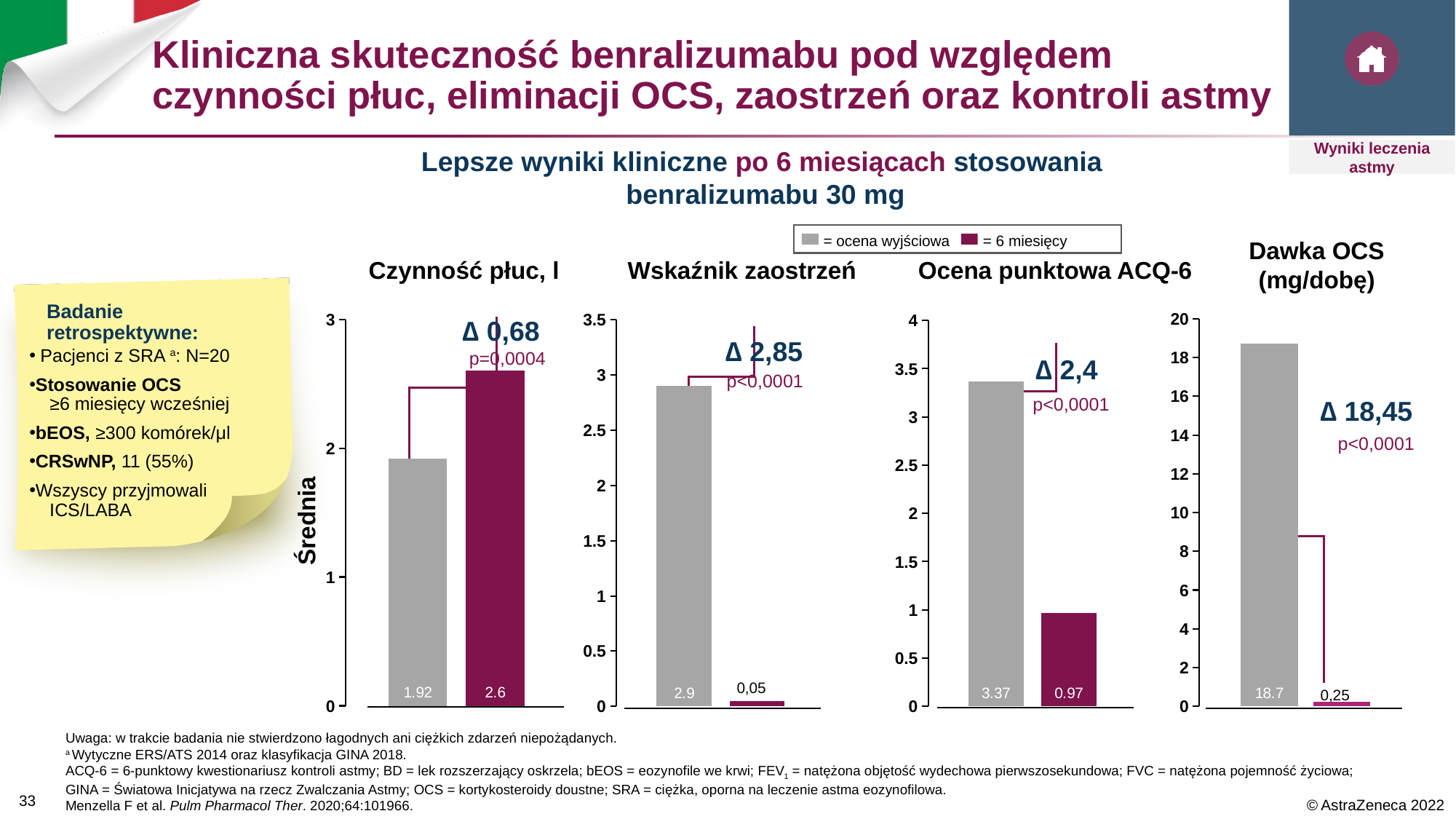
How many series does the shared legend list for the charts? 2 In the 'Dawka OCS (mg/dobę)' chart, what is the difference between the ocena wyjściowa and 6 miesięcy values? 18,45 In the 'Ocena punktowa ACQ-6' chart, which bar is lower, ocena wyjściowa or 6 miesięcy? 6 miesięcy In the 'Ocena punktowa ACQ-6' chart, what is the value for 6 miesięcy? 0.97 In the 'Czynność płuc, l' chart, what is the value for 6 miesięcy? 2.6 In the 'Czynność płuc, l' chart, what is the value for ocena wyjściowa? 1.92 In the 'Dawka OCS (mg/dobę)' chart, what is the value for ocena wyjściowa? 18.7 In the 'Czynność płuc, l' chart, which bar is higher, ocena wyjściowa or 6 miesięcy? 6 miesięcy In the 'Wskaźnik zaostrzeń' chart, what is the value for ocena wyjściowa? 2.9 In the 'Dawka OCS (mg/dobę)' chart, what is the value for 6 miesięcy? 0,25 What kind of chart is 'Wskaźnik zaostrzeń'? Bar chart In the 'Wskaźnik zaostrzeń' chart, what is the value for 6 miesięcy? 0,05